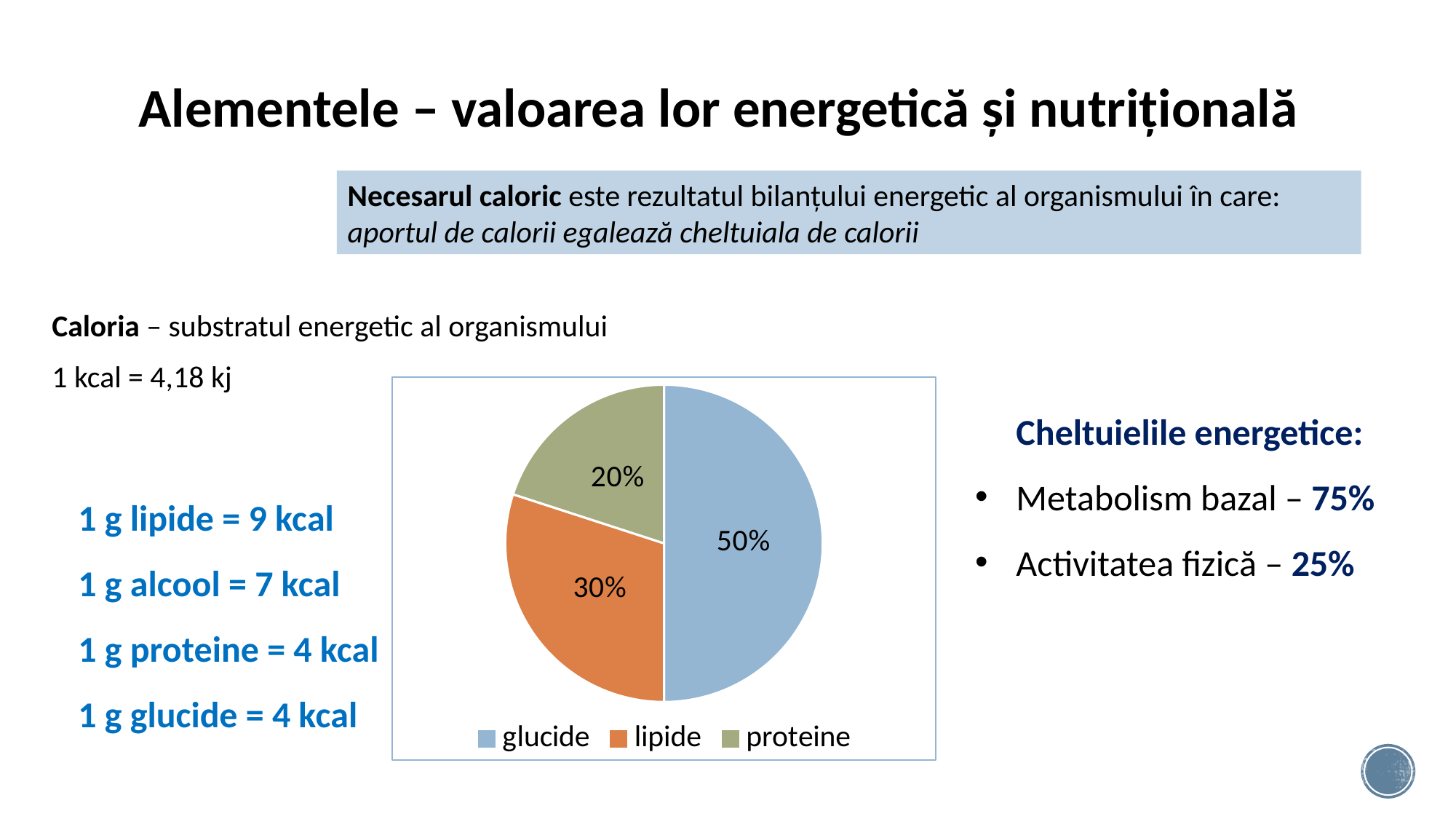
How many entries does the legend list? 3 Which category has the smallest slice of the pie? proteine What share of the pie does proteine take? 20% What is the difference in percentage points between the glucide and lipide slices? 20% What kind of chart is shown on the slide? pie chart How many slices does the pie chart have? 3 What share of the pie does lipide take? 30% Which slice is larger, lipide or proteine? lipide What share of the pie does glucide take? 50% Which category has the largest slice of the pie? glucide What colour is the glucide slice in the pie chart? blue What is the difference in percentage points between the lipide and proteine slices? 10%